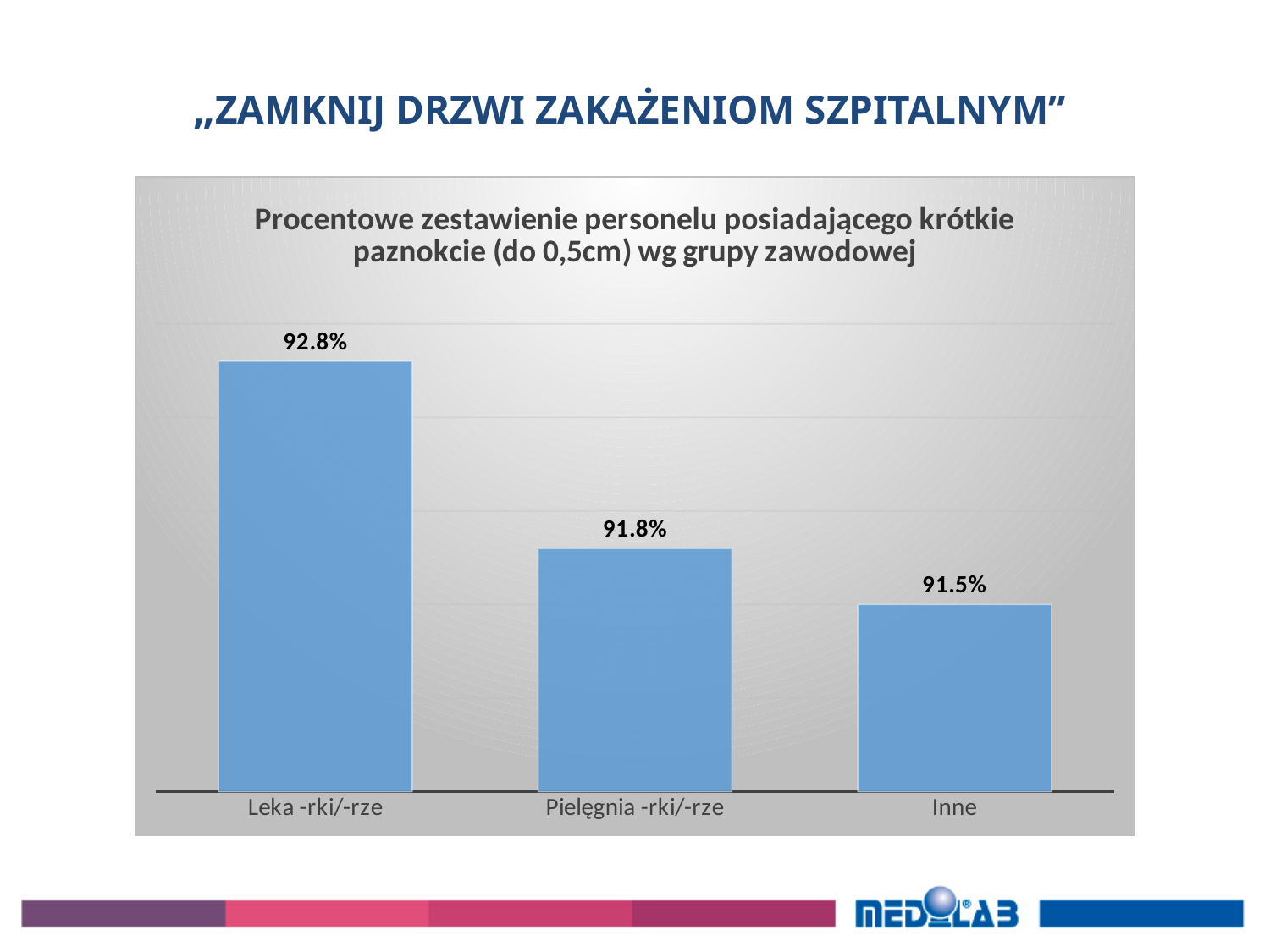
What kind of chart is shown on the slide? Bar chart What is the value for Pielęgnia -rki/-rze? 91.8% Which category has the lowest value? Inne What is the difference between the values for Leka -rki/-rze and Pielęgnia -rki/-rze? 1.0% What is the value for Inne? 91.5% What is the value for Leka -rki/-rze? 92.8% What is the title of the chart? Procentowe zestawienie personelu posiadającego krótkie paznokcie (do 0,5cm) wg grupy zawodowej Which category has the highest value? Leka -rki/-rze How many categories are shown in the chart? 3 Which is larger, the value for Pielęgnia -rki/-rze or the value for Inne? Pielęgnia -rki/-rze What is the difference between the values for Leka -rki/-rze and Inne? 1.3% Do the values rise or fall from left to right along the x axis? Fall